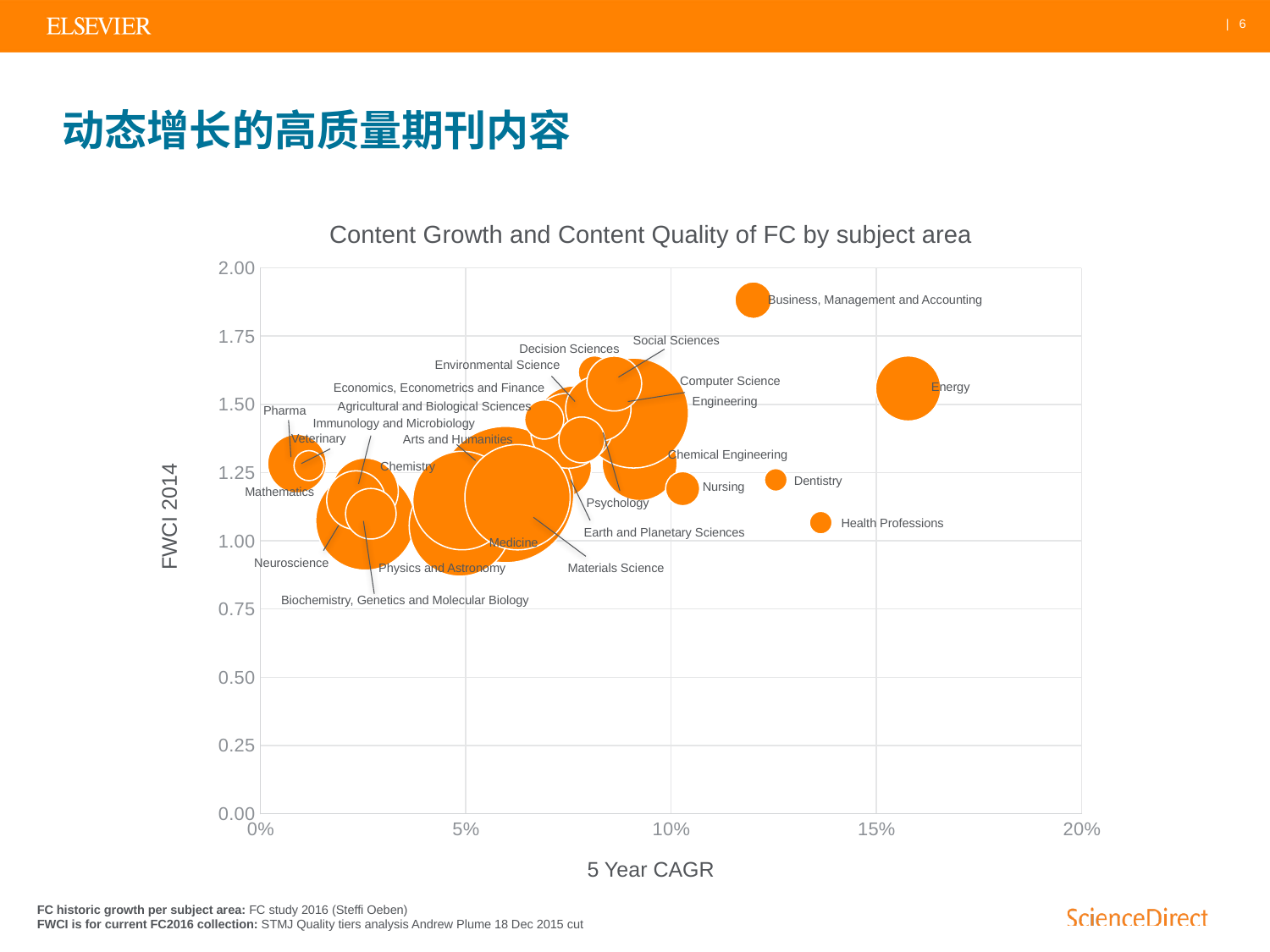
What is the label of the vertical axis of the chart? FWCI 2014 Which subject area has the highest FWCI 2014 value in the chart? Business, Management and Accounting How many subject areas are labelled in the chart? 26 Which has the higher FWCI 2014 value, Business, Management and Accounting or Energy? Business, Management and Accounting What is the title of the chart? Content Growth and Content Quality of FC by subject area Is the FWCI 2014 value for Health Professions greater or less than 1.25? less Which subject area has the highest 5 Year CAGR in the chart? Energy Is the 5 Year CAGR for Dentistry greater or less than 10%? greater Is the 5 Year CAGR for Energy greater or less than 15%? greater What kind of chart is shown on the slide? Bubble chart Which has the larger 5 Year CAGR, Energy or Business, Management and Accounting? Energy